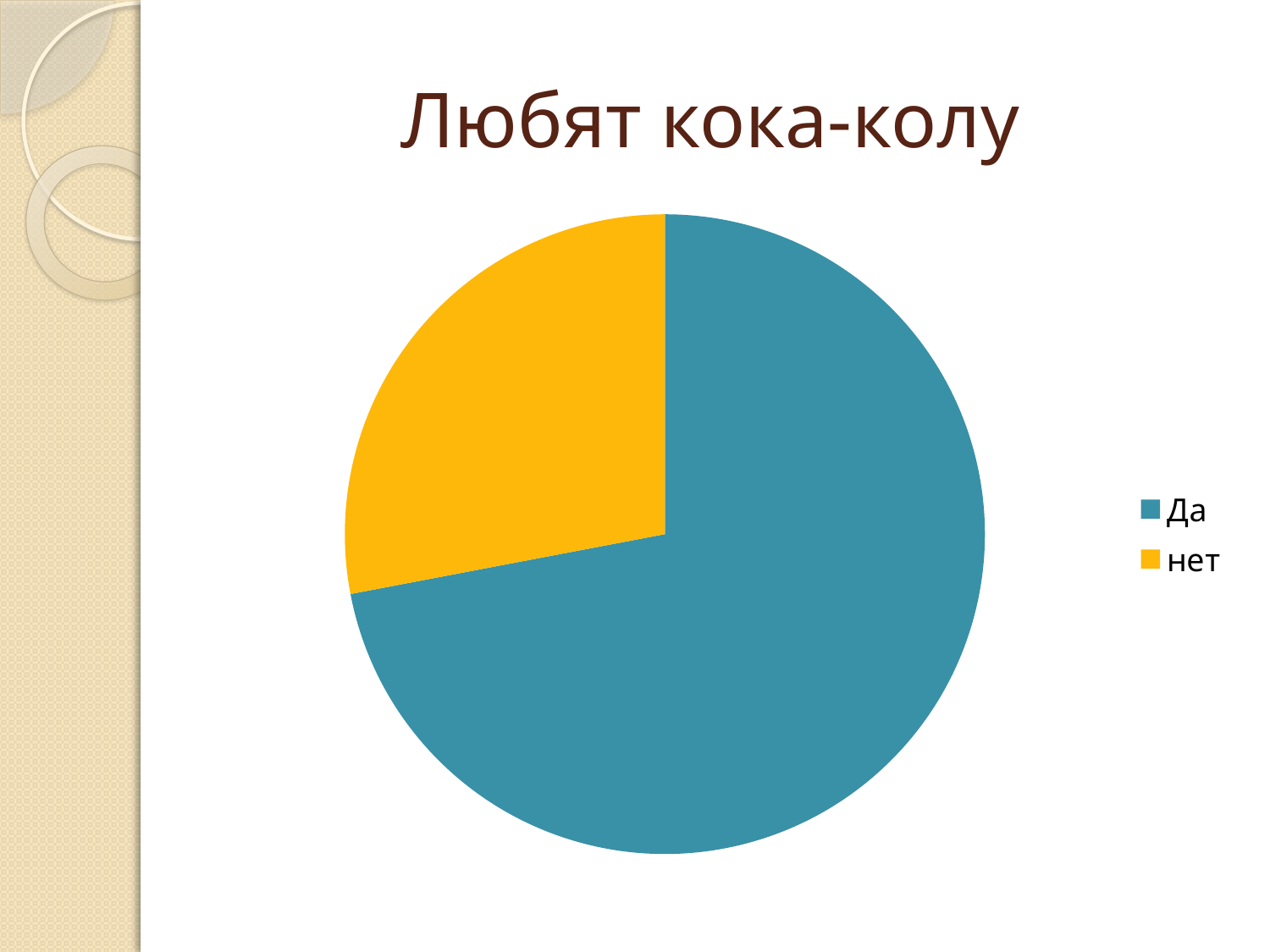
Which category has the largest slice of the pie? Да Which category has the smallest slice of the pie? нет Does the "Да" slice take up more or less than half of the pie? more What colour is the slice for "нет"? yellow What kind of chart is shown on the slide? pie chart Which slice is larger, "Да" or "нет"? Да How many slices does the pie chart have? 2 How many entries does the legend list? 2 What is the title of the chart? Любят кока-колу